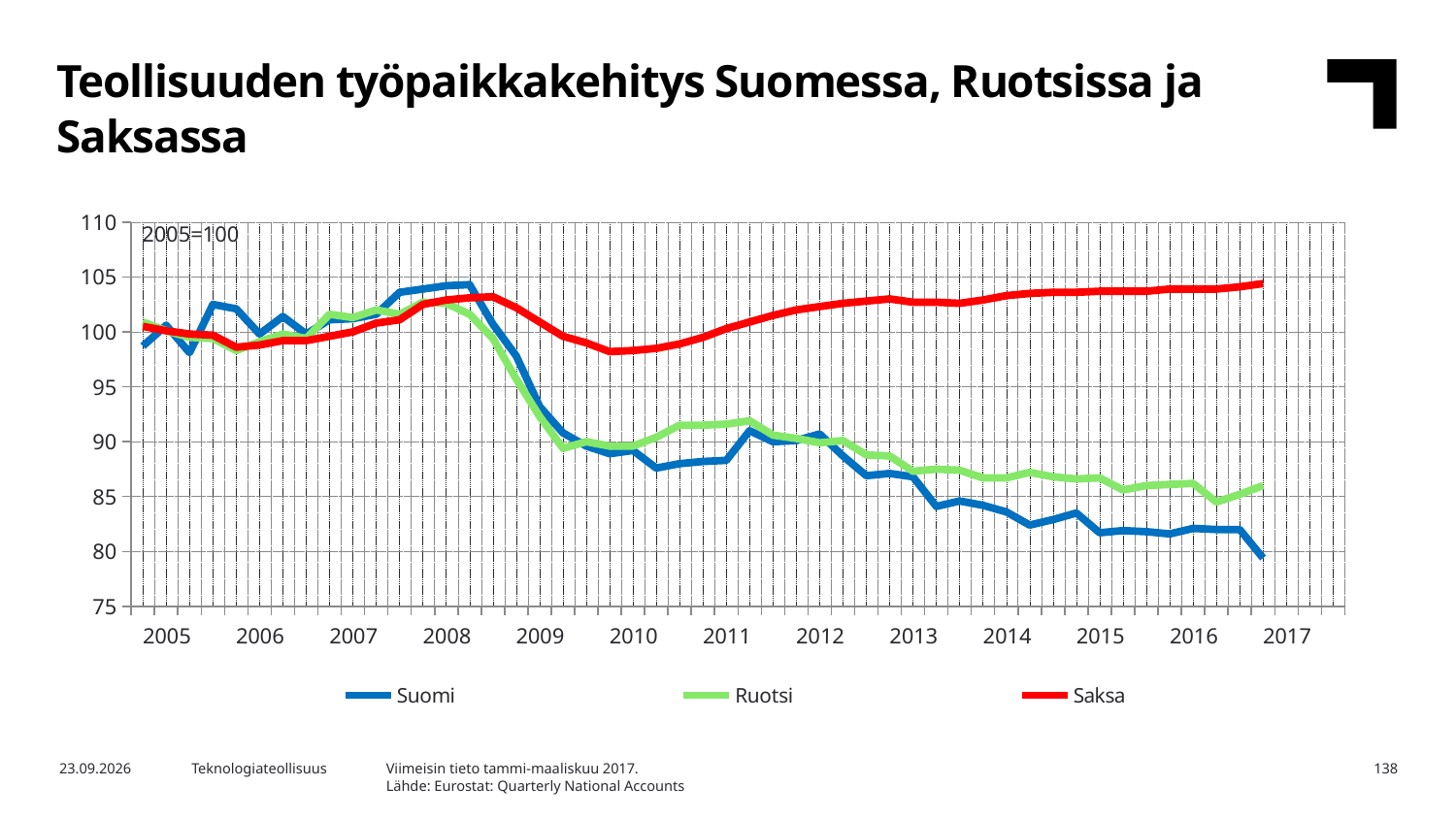
What kind of chart is shown on the slide? line chart Which series has the highest value at the end of the chart (2017)? Saksa At 2014, which is higher: Ruotsi or Suomi? Ruotsi Is the value for Saksa at 2016 greater or less than 100? greater How many year labels are shown on the x axis? 13 Is the value for Suomi at 2016 greater or less than 85? less Which countries are listed in the chart legend? Suomi, Ruotsi, Saksa Is the value for Ruotsi at 2016 greater or less than 90? less How many series does the legend list? 3 Which series has the lowest value at the end of the chart (2017)? Suomi What base year and index value is noted in the chart? 2005=100